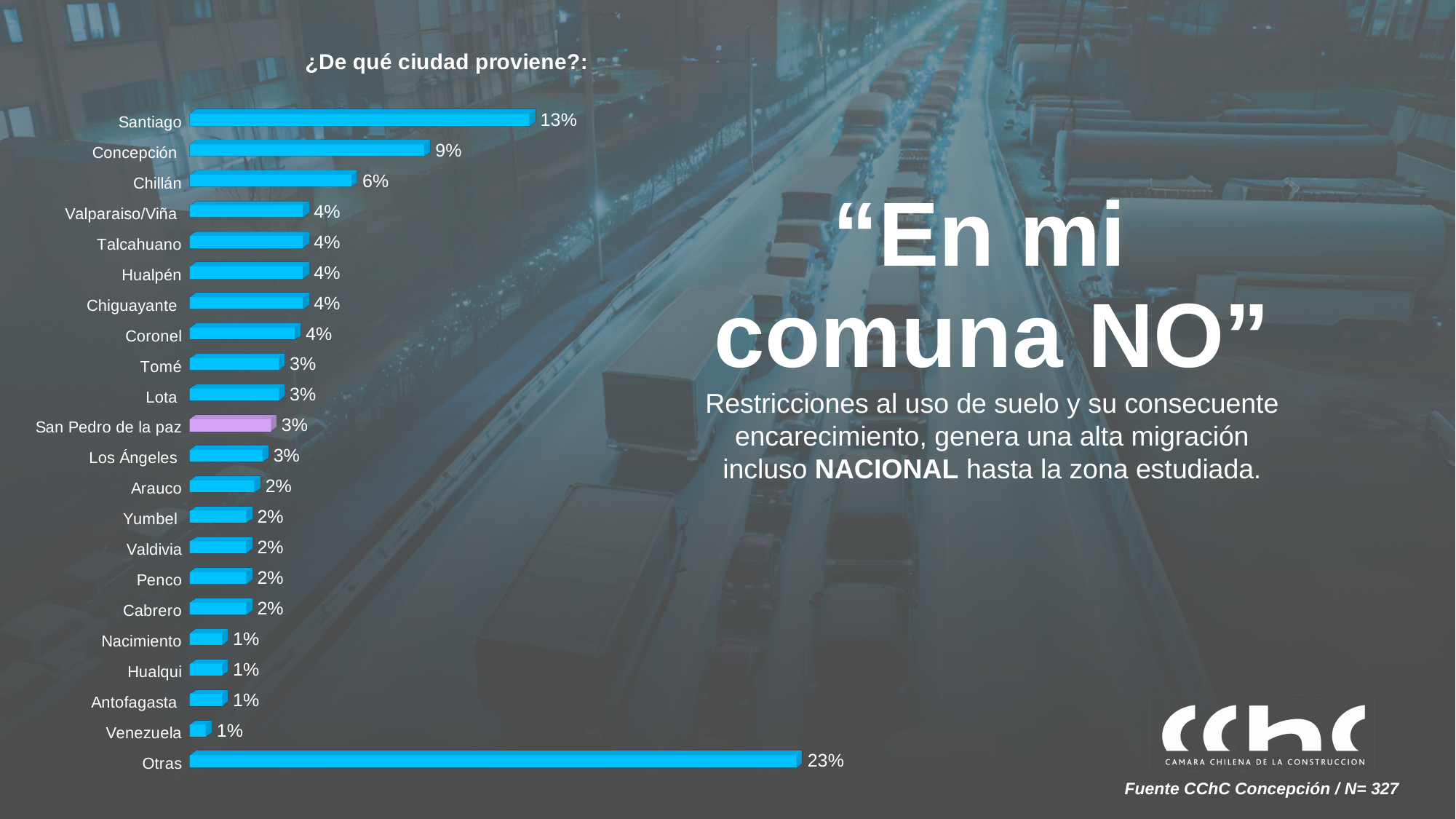
What is the value for Chillán? 6% Which category has the highest value? Otras How many categories are shown in the chart? 22 What is the title of the chart? ¿De qué ciudad proviene?: What is the value for San Pedro de la paz? 3% What is the difference between the values for Santiago and Concepción? 4% What kind of chart is shown on the slide? Bar chart What is the value for Concepción? 9% What is the value for Otras? 23% Which is larger, the value for Chillán or the value for Coronel? Chillán What is the difference between the values for Otras and Santiago? 10% What is the value for Santiago? 13%